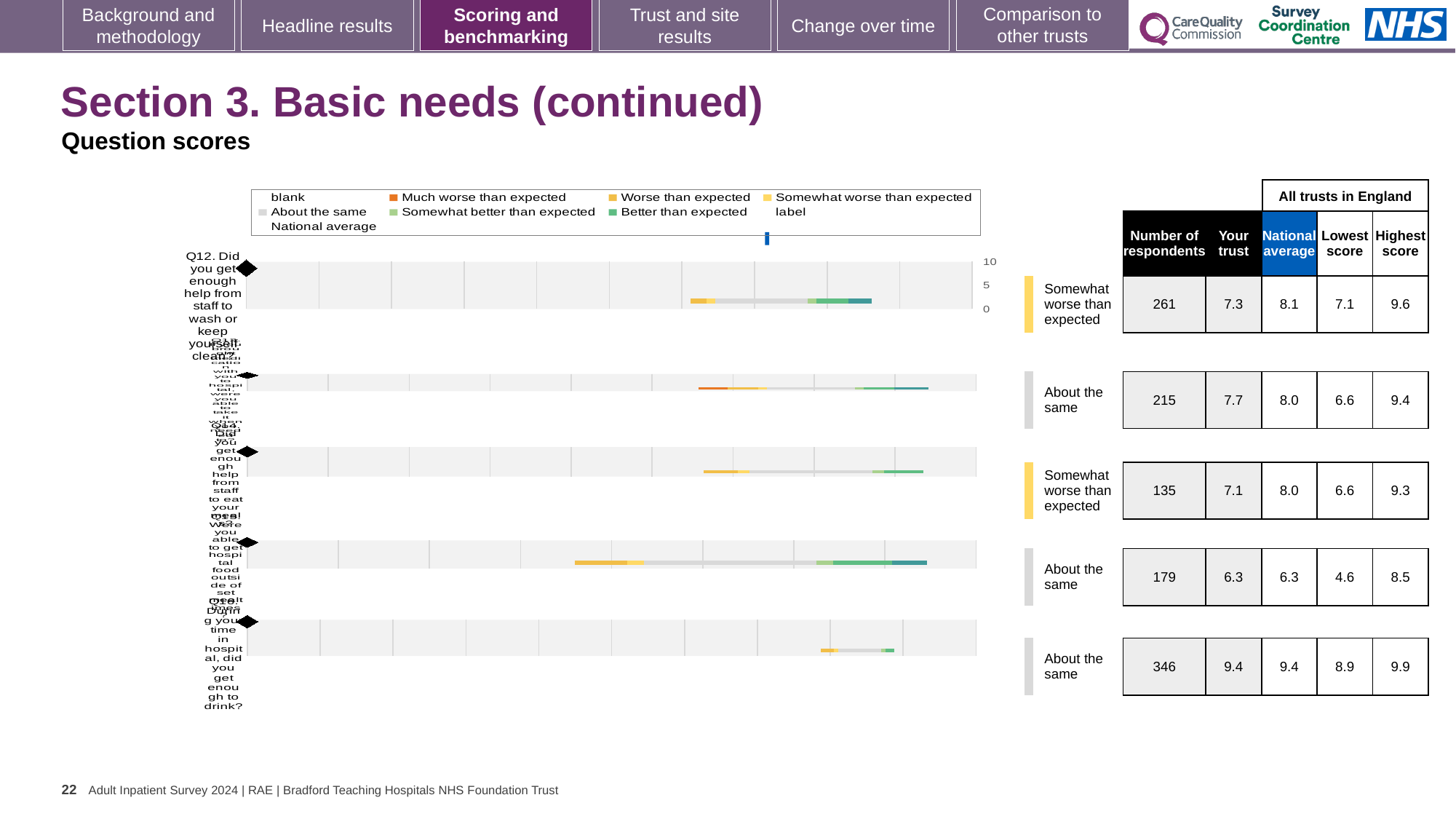
What benchmark category is shown for Q12 (help from staff to wash or keep yourself clean)? Somewhat worse than expected What kind of chart is used to show the question scores on this slide? bar chart Which question has the lowest 'Your trust' score? Q15 (hospital food outside of set meal times) How many respondents are shown for Q12 (help from staff to wash or keep yourself clean)? 261 What is the 'Your trust' score for Q12 (help from staff to wash or keep yourself clean)? 7.3 What colour does the legend use for 'Better than expected'? Green For Q14 (help from staff to eat your meals), which is larger: the 'Your trust' score or the national average? National average What is the lowest score across all trusts in England for Q15 (hospital food outside of set meal times)? 4.6 How many questions are plotted in the question scores chart? 5 For Q12, how much higher is the national average than the 'Your trust' score? 0.8 Which question has the highest 'Your trust' score? Q16 (did you get enough to drink?) What is the highest score across all trusts in England for Q16 (did you get enough to drink)? 9.9